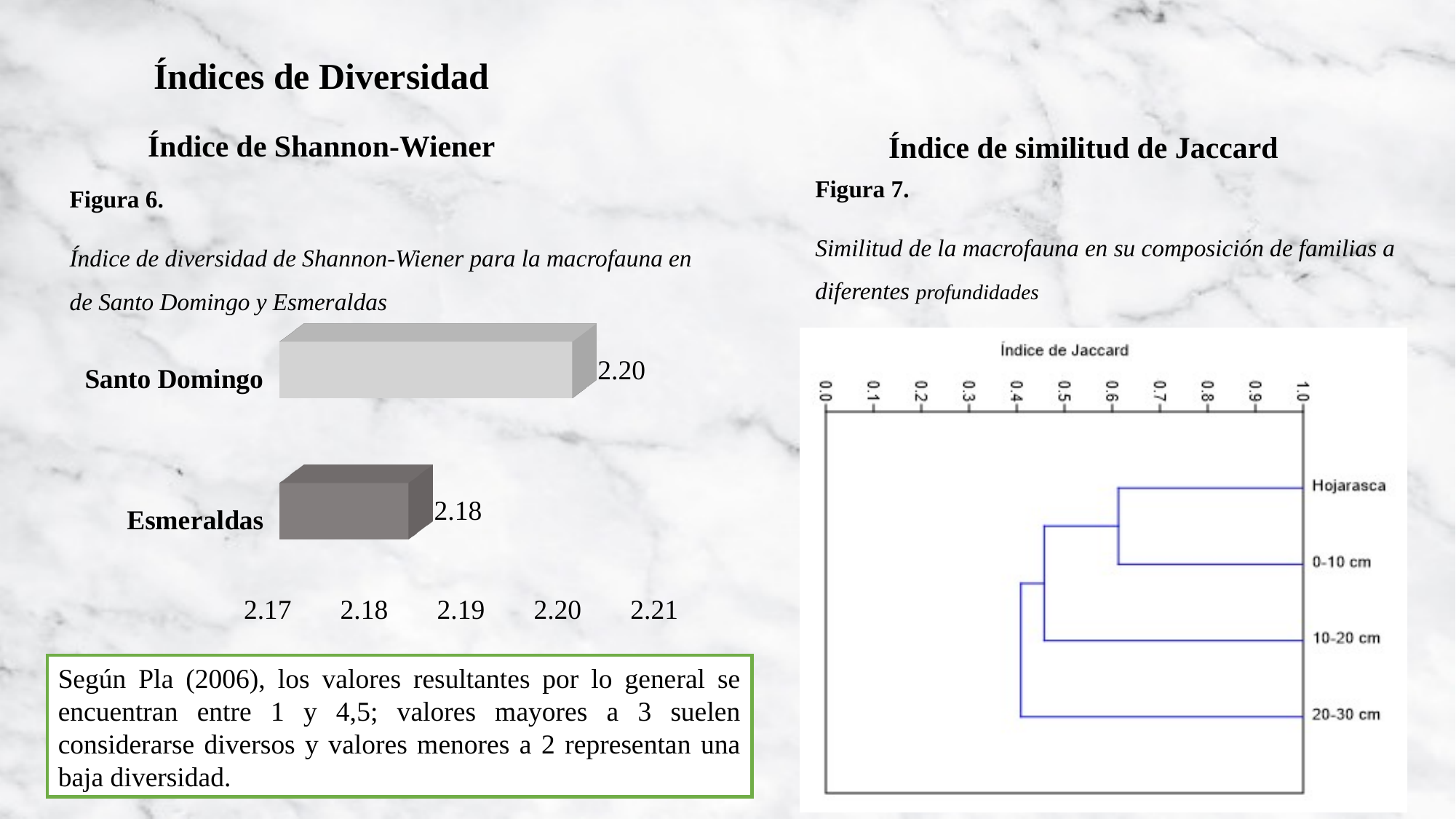
In the Shannon-Wiener bar chart (Figura 6), what is the highest value shown on the x axis? 2.21 In the Shannon-Wiener bar chart (Figura 6), how many locations are plotted? 2 In the Shannon-Wiener bar chart (Figura 6), which location has the lower diversity index? Esmeraldas In the Jaccard dendrogram (Figura 7), is the Jaccard index at which Hojarasca and 0-10 cm join greater or less than 0.5? greater In the Shannon-Wiener bar chart (Figura 6), what is the difference between the values for Santo Domingo and Esmeraldas? 0.02 In the Shannon-Wiener bar chart (Figura 6), what is the value for Esmeraldas? 2.18 In the Jaccard dendrogram (Figura 7), is the Jaccard index at which 20-30 cm joins the other samples greater or less than 0.5? less What kind of chart is Figura 6 (Índice de Shannon-Wiener)? Bar chart In the Jaccard dendrogram (Figura 7), how many samples (leaves) are listed on the right side? 4 In the Shannon-Wiener bar chart (Figura 6), which location has the higher diversity index? Santo Domingo In the Shannon-Wiener bar chart (Figura 6), what is the value for Santo Domingo? 2.20 What kind of chart is Figura 7 (Índice de similitud de Jaccard)? Dendrogram